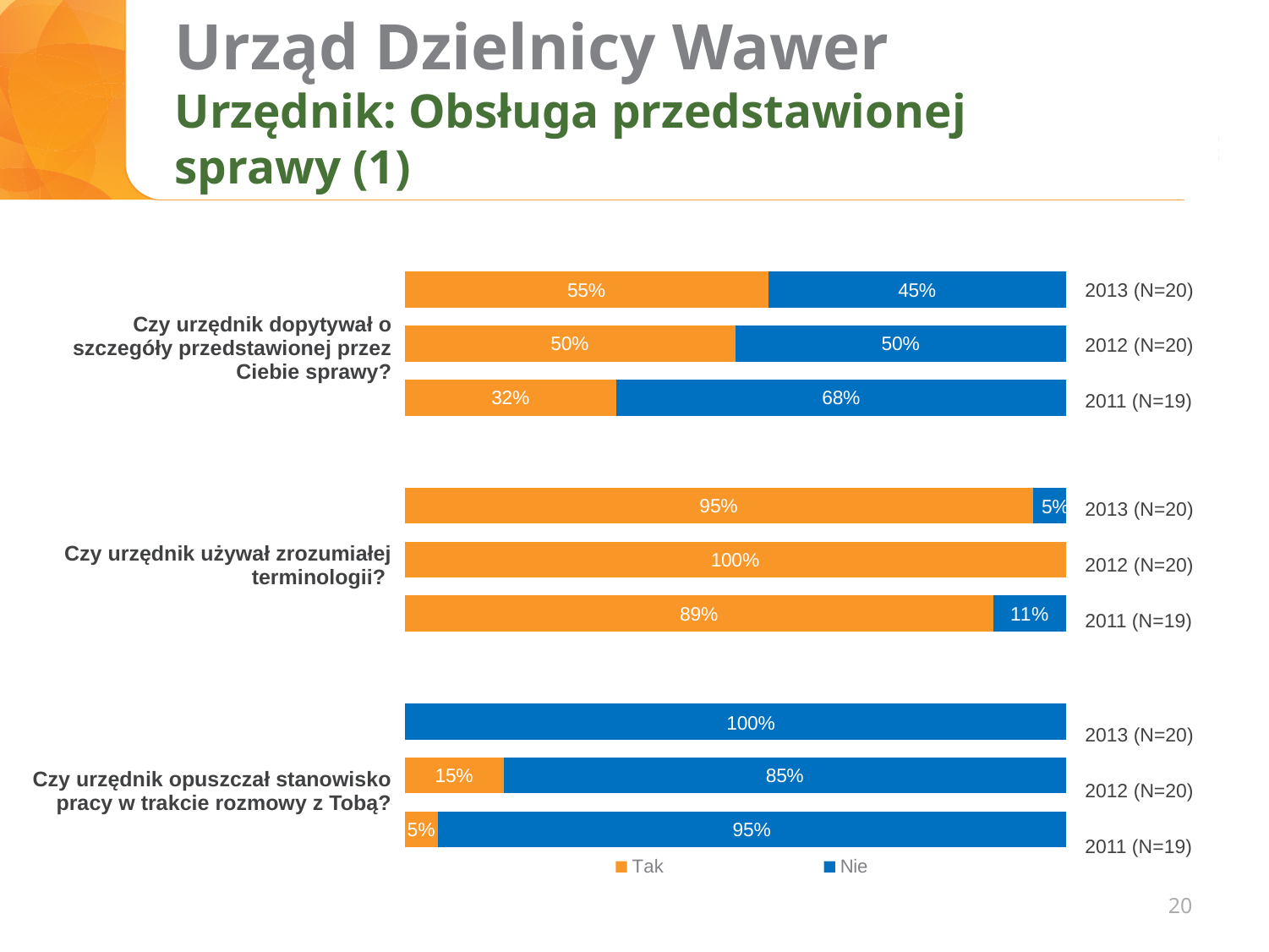
In the chart for "Czy urzędnik używał zrozumiałej terminologii?", what is the "Nie" value for 2011 (N=19)? 11% In the chart for "Czy urzędnik używał zrozumiałej terminologii?", what is the "Tak" value for 2012 (N=20)? 100% In the chart for "Czy urzędnik dopytywał o szczegóły przedstawionej przez Ciebie sprawy?", what is the "Tak" value for 2013 (N=20)? 55% In the chart for "Czy urzędnik opuszczał stanowisko pracy w trakcie rozmowy z Tobą?", what is the "Tak" value for 2012 (N=20)? 15% In the chart for "Czy urzędnik dopytywał o szczegóły przedstawionej przez Ciebie sprawy?", what is the "Nie" value for 2011 (N=19)? 68% In the chart for "Czy urzędnik dopytywał o szczegóły przedstawionej przez Ciebie sprawy?", which year has the highest "Tak" value? 2013 (N=20) What kind of chart is used on this slide? Stacked bar chart In the chart for "Czy urzędnik opuszczał stanowisko pracy w trakcie rozmowy z Tobą?", is the "Nie" value for 2012 (N=20) larger or smaller than the "Nie" value for 2011 (N=19)? smaller In the chart for "Czy urzędnik używał zrozumiałej terminologii?", which year has the lowest "Tak" value? 2011 (N=19) How many series does the legend list? 2 In the chart for "Czy urzędnik dopytywał o szczegóły przedstawionej przez Ciebie sprawy?", what is the difference between the "Nie" and "Tak" values for 2011 (N=19)? 36% In the chart for "Czy urzędnik opuszczał stanowisko pracy w trakcie rozmowy z Tobą?", what is the "Nie" value for 2013 (N=20)? 100%